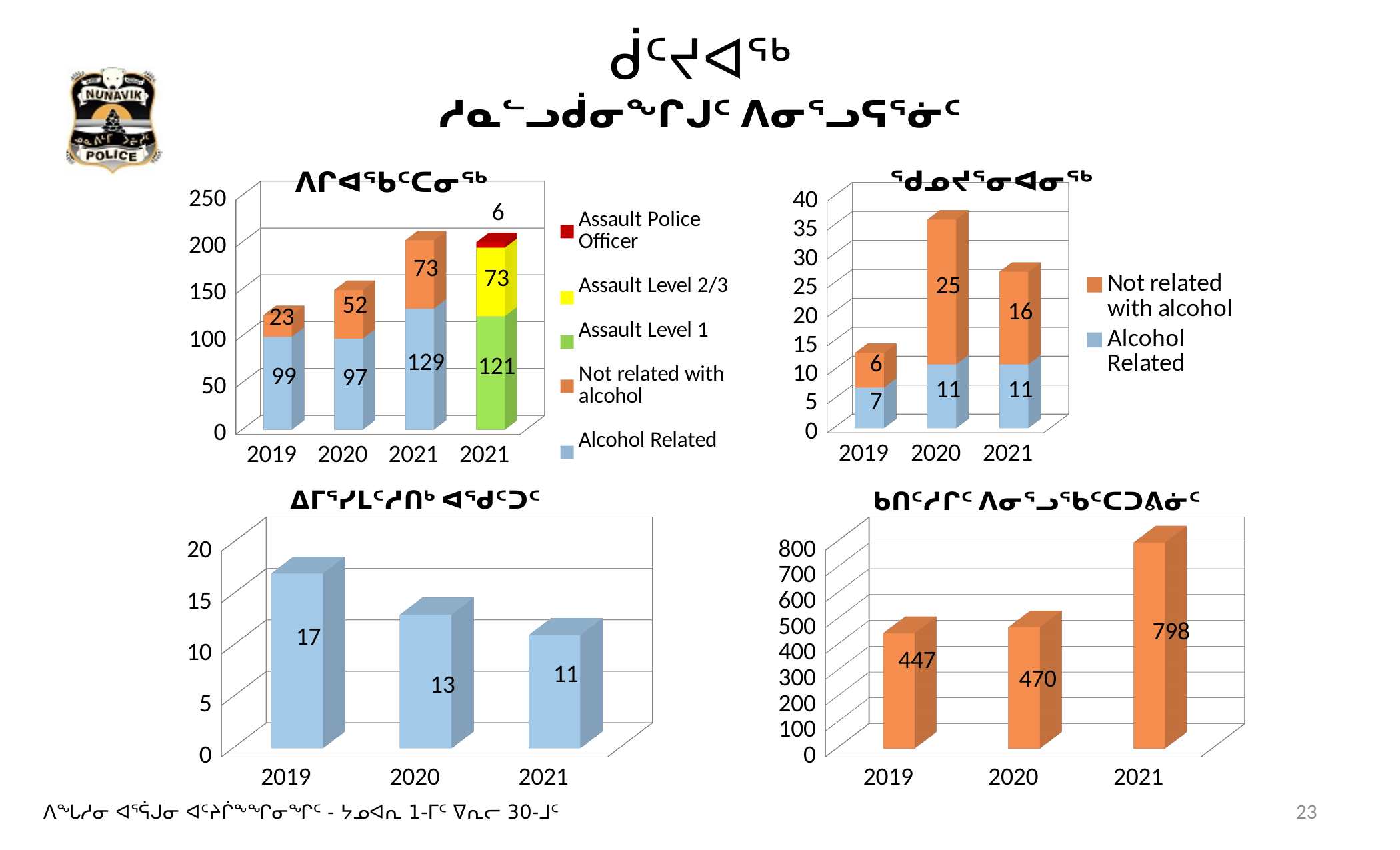
In the top-left chart, what is the Alcohol Related value for 2021? 129 In the top-right chart, what is the Not related with alcohol value for 2020? 25 What kind of chart is the bottom-right chart? bar chart In the top-right chart, which year has the highest Not related with alcohol value? 2020 In the bottom-right chart, what is the difference between the 2020 and 2019 values? 23 In the bottom-right chart, what is the value for 2021? 798 In the top-left chart, what is the total of the 2020 stacked bar (Alcohol Related plus Not related with alcohol)? 149 How many series does the legend of the top-left chart list? 5 In the bottom-left chart, do the values rise or fall from 2019 to 2021? fall In the top-right chart, what is the difference between the Not related with alcohol value and the Alcohol Related value in 2021? 5 In the bottom-left chart, what is the value for 2019? 17 In the top-left chart, what is the Assault Police Officer value for the second 2021 bar? 6